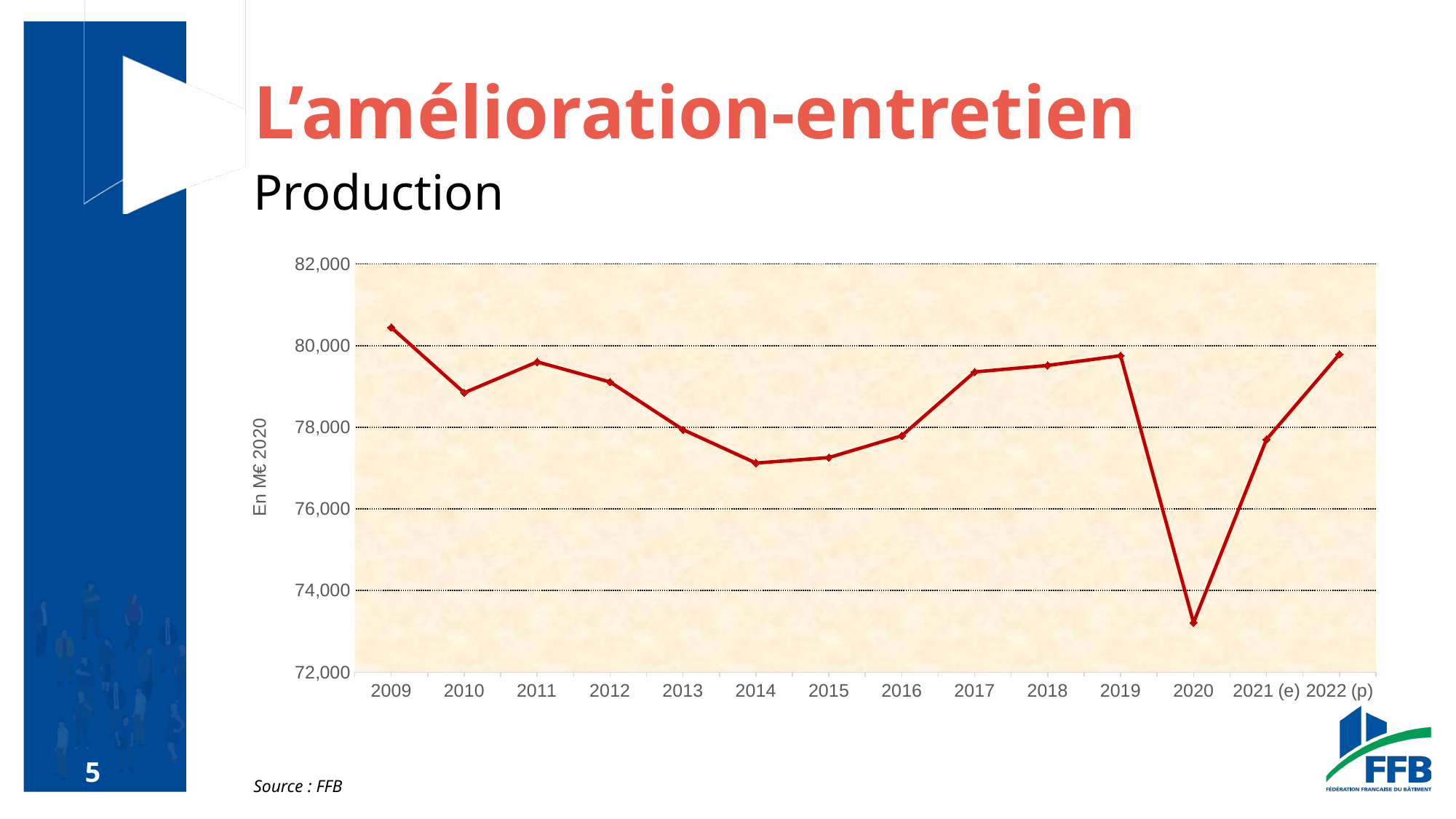
Which year has the larger value, 2010 or 2011? 2011 Is the value for 2014 greater or less than 78,000? less Is the value for 2020 greater or less than 74,000? less What kind of chart is shown on the slide? line chart Is the value for 2009 greater or less than 80,000? greater Which has the larger value, 2021 (e) or 2022 (p)? 2022 (p) What is the label on the vertical axis of the chart? En M€ 2020 Does the production value rise or fall between 2019 and 2020? fall Which year has the lowest production value in the chart? 2020 Which year has the highest production value in the chart? 2009 How many years are plotted on the x axis of the chart? 14